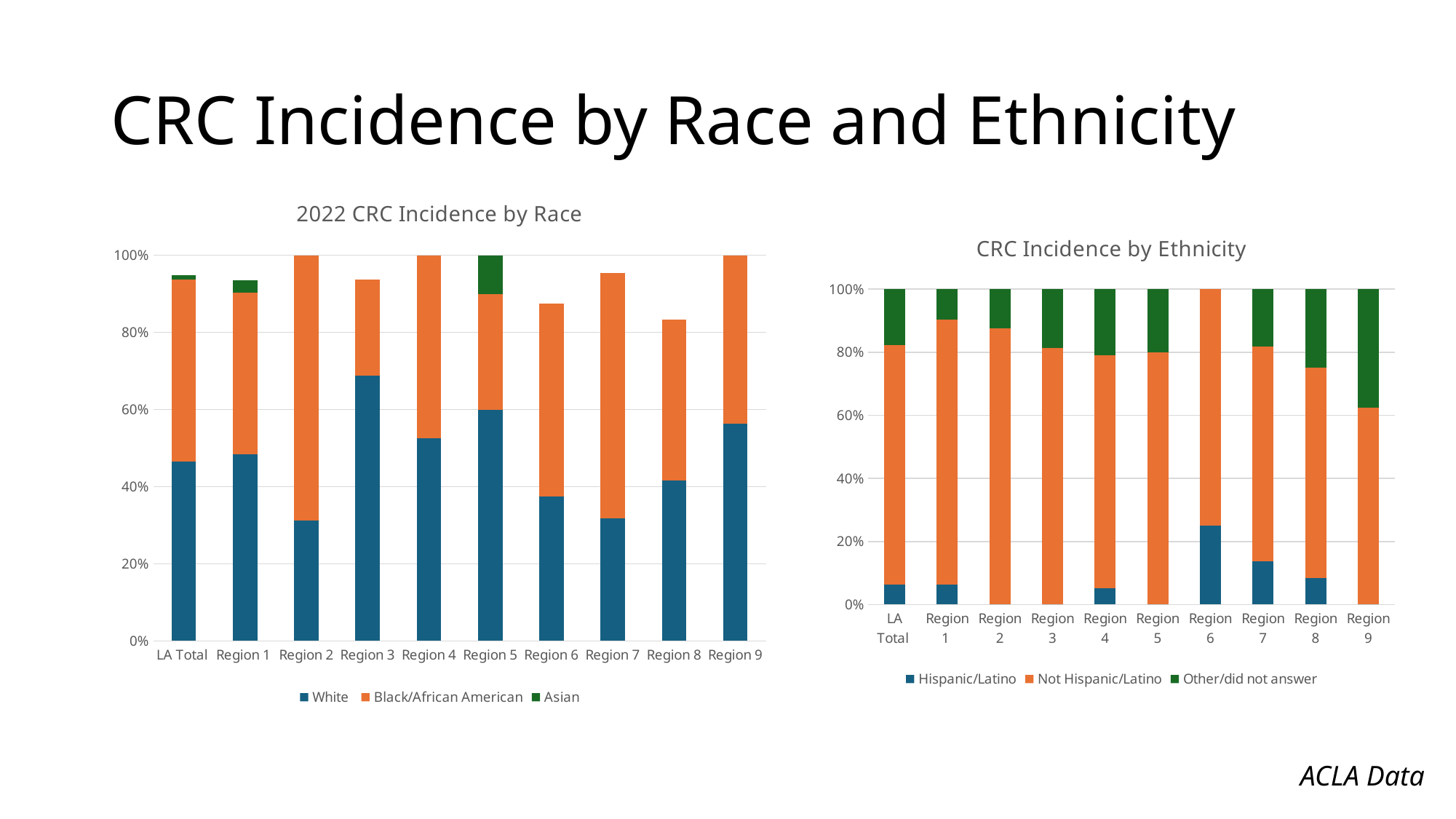
In the '2022 CRC Incidence by Race' chart, which has a larger White share, Region 2 or Region 3? Region 3 How many categories are shown on the x axis of the '2022 CRC Incidence by Race' chart? 10 In the 'CRC Incidence by Ethnicity' chart, which category has the largest Other/did not answer share? Region 9 How many series does the legend of the 'CRC Incidence by Ethnicity' chart list? 3 In the 'CRC Incidence by Ethnicity' chart, is the Hispanic/Latino share for Region 6 greater or less than 20%? greater How many series does the legend of the '2022 CRC Incidence by Race' chart list? 3 In the '2022 CRC Incidence by Race' chart, is the White share for Region 2 greater or less than 40%? less In the 'CRC Incidence by Ethnicity' chart, which category has the highest Hispanic/Latino share? Region 6 In the '2022 CRC Incidence by Race' chart, which category has the highest White share? Region 3 What kind of chart is the '2022 CRC Incidence by Race' chart? stacked bar chart Which colour represents the Not Hispanic/Latino series in the 'CRC Incidence by Ethnicity' chart? orange In the '2022 CRC Incidence by Race' chart, is the White share for Region 3 greater or less than 60%? greater